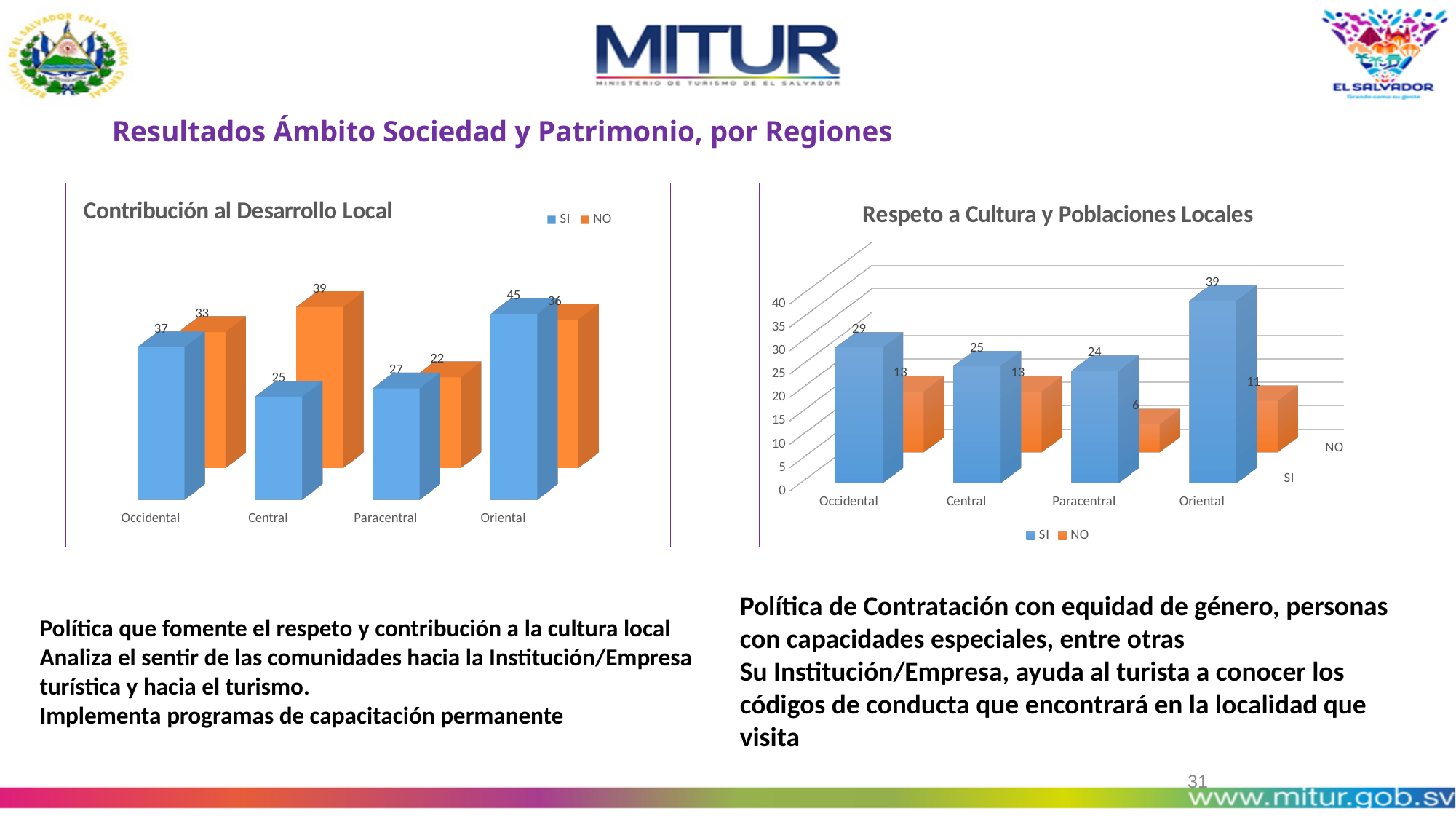
In the 'Contribución al Desarrollo Local' chart, what is the NO value for Central? 39 How many regions are shown on the x axis of the 'Respeto a Cultura y Poblaciones Locales' chart? 4 In the 'Respeto a Cultura y Poblaciones Locales' chart, what is the NO value for Paracentral? 6 In the 'Contribución al Desarrollo Local' chart, which is larger for Occidental, SI or NO? SI In the 'Contribución al Desarrollo Local' chart, which region has the lowest SI value? Central How many series does the legend of the 'Contribución al Desarrollo Local' chart list? 2 In the 'Respeto a Cultura y Poblaciones Locales' chart, what is the difference between the SI and NO values for Occidental? 16 In the 'Respeto a Cultura y Poblaciones Locales' chart, which region has the highest SI value? Oriental In the 'Contribución al Desarrollo Local' chart, what is the difference between the SI and NO values for Paracentral? 5 In the 'Contribución al Desarrollo Local' chart, what is the SI value for Oriental? 45 What type of chart is 'Respeto a Cultura y Poblaciones Locales'? Bar chart In the 'Respeto a Cultura y Poblaciones Locales' chart, what is the SI value for Oriental? 39